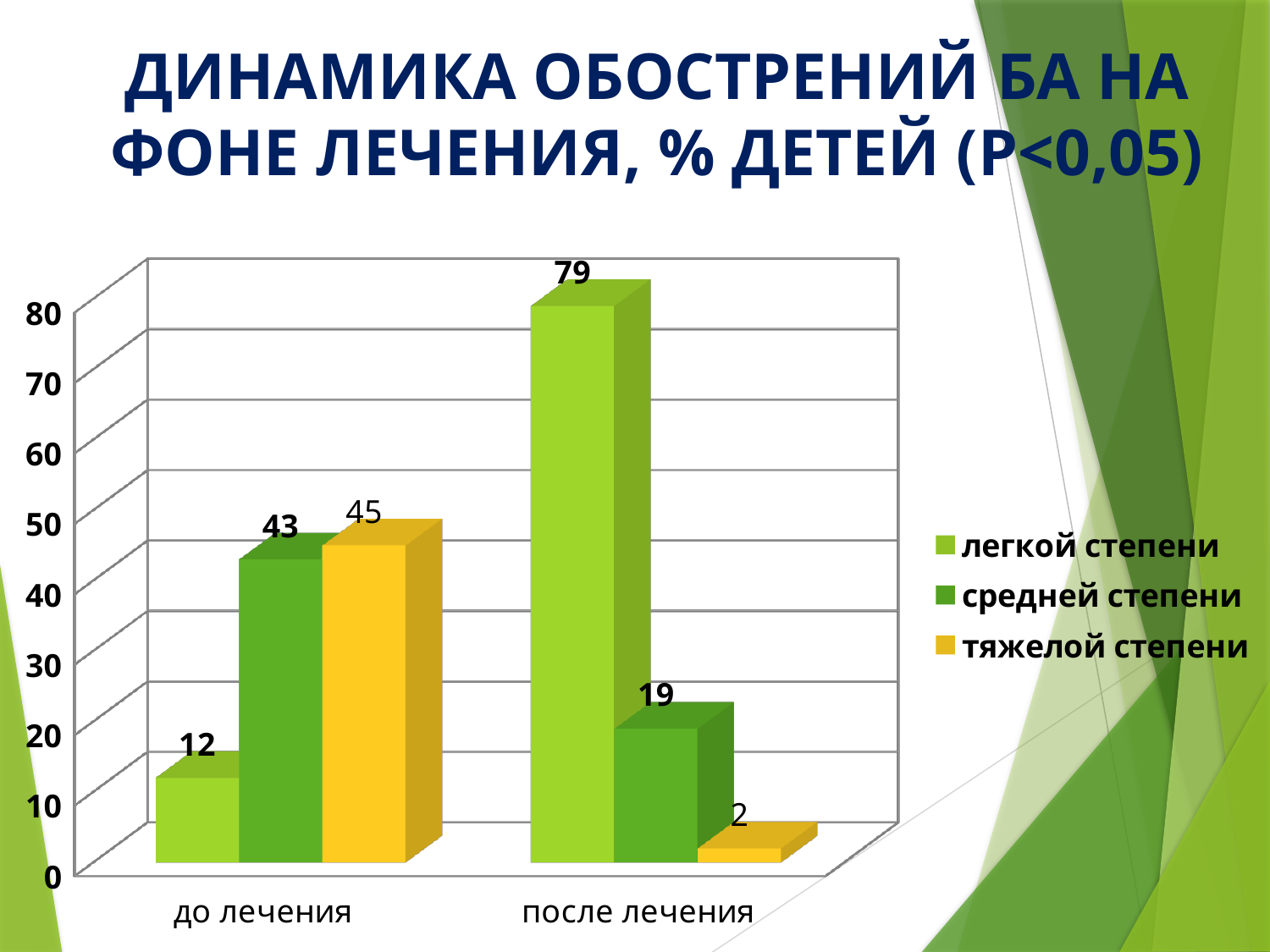
What is the value for легкой степени in the после лечения category? 79 Which series has the lowest value in the до лечения category? легкой степени How many categories are shown on the x axis? 2 What is the value for легкой степени in the до лечения category? 12 Which colour represents the тяжелой степени series in the legend? yellow How many series does the legend list? 3 Which series has the highest value in the после лечения category? легкой степени What kind of chart is shown on the slide? bar chart What is the value for тяжелой степени in the после лечения category? 2 What is the value for средней степени in the до лечения category? 43 What is the difference between the легкой степени values for после лечения and до лечения? 67 Which is larger: средней степени in до лечения or средней степени in после лечения? средней степени in до лечения